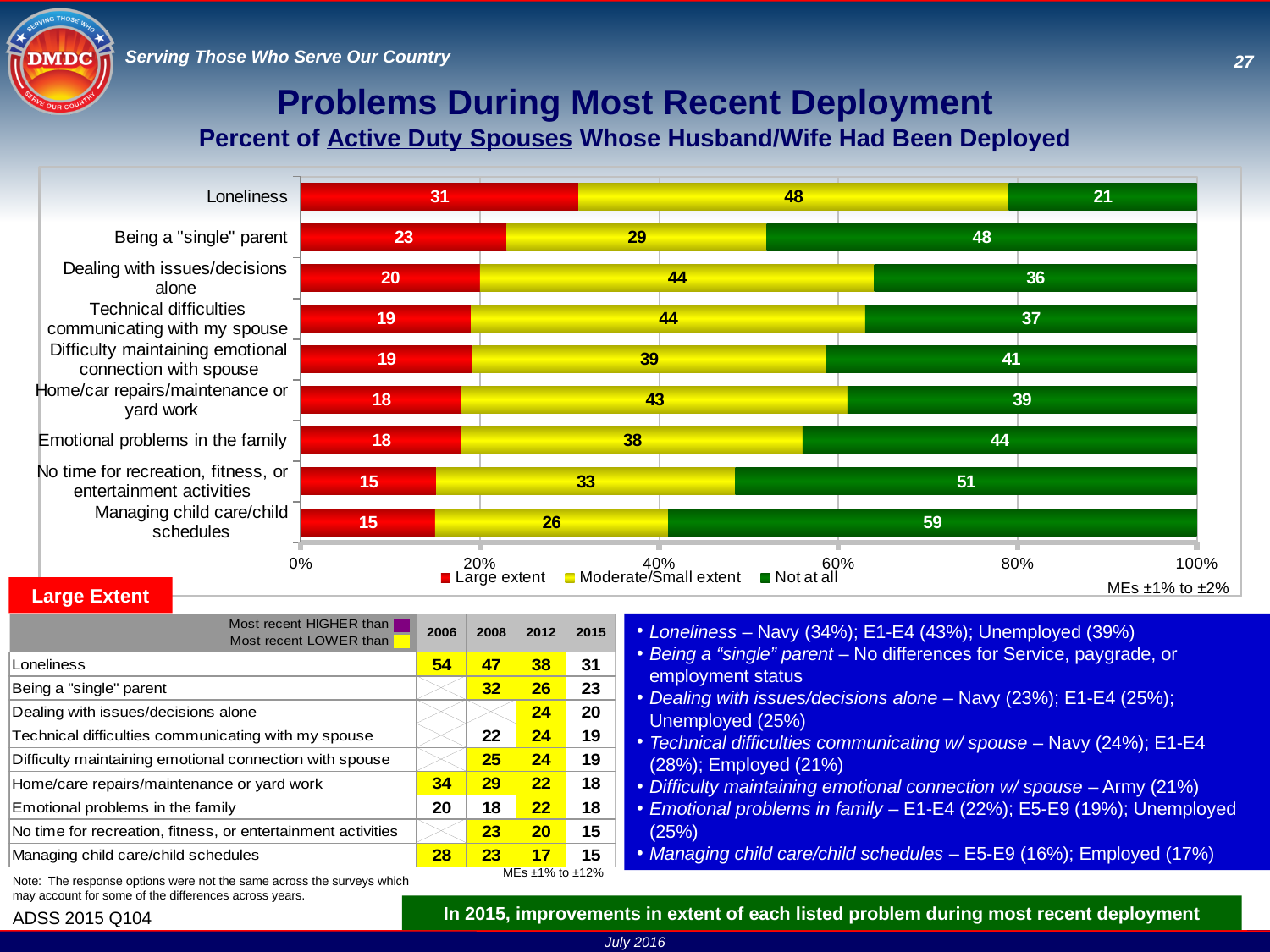
What is the "Not at all" value for Managing child care/child schedules? 59 Which is larger: the "Moderate/Small extent" value for Loneliness or for Emotional problems in the family? Loneliness How many series does the legend list? 3 What is the "Moderate/Small extent" value for Being a "single" parent? 29 Which category has the highest "Large extent" value? Loneliness What is the total of the stacked bar for No time for recreation, fitness, or entertainment activities? 99 How many categories are shown in the chart? 9 What is the difference between the "Not at all" values for Managing child care/child schedules and Loneliness? 38 Which category has the lowest "Not at all" value? Loneliness What is the "Large extent" value for Loneliness? 31 What kind of chart is shown on the slide? Stacked bar chart Which series is shown in red in the chart? Large extent